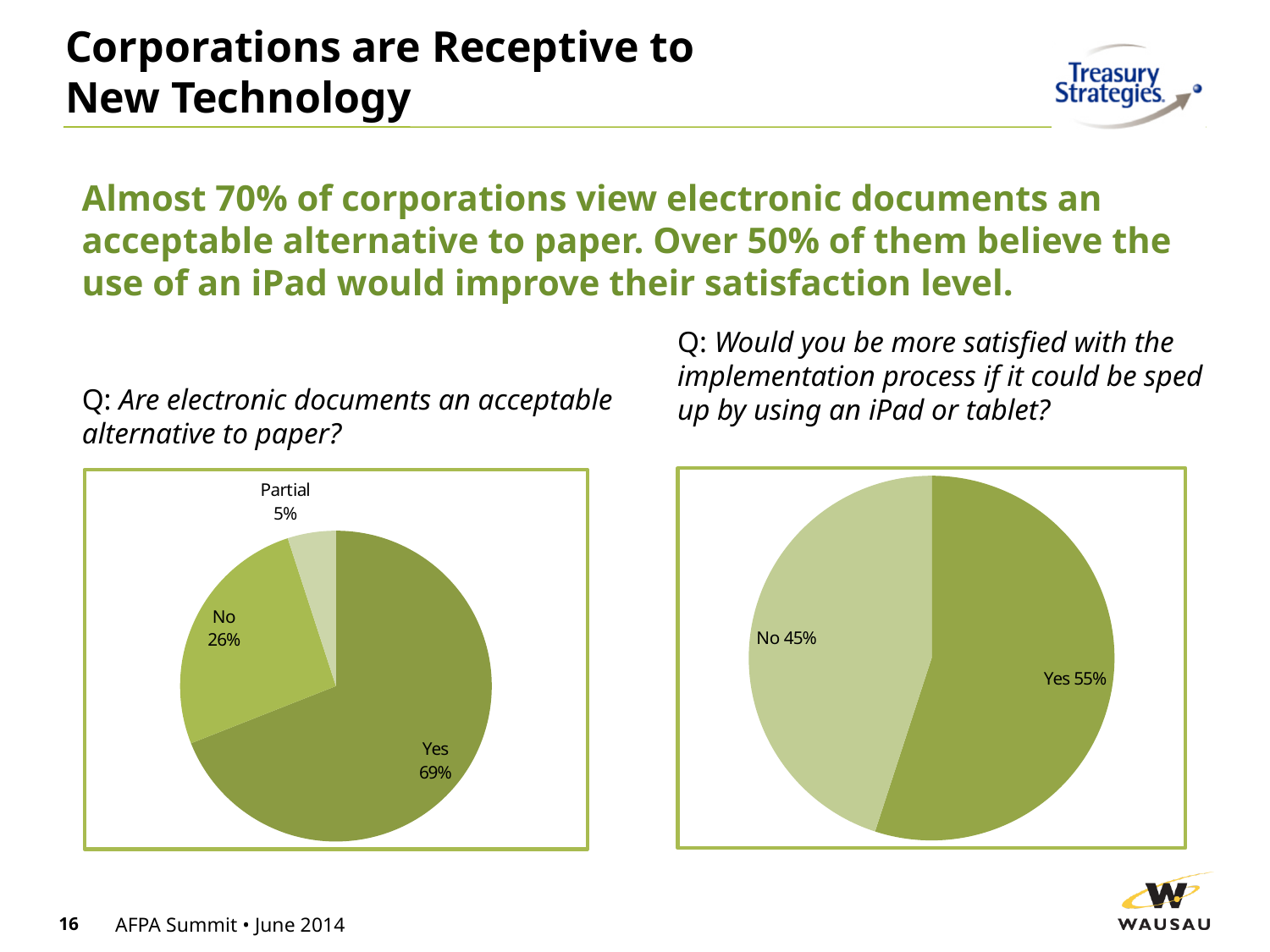
In the left pie chart (electronic documents as an acceptable alternative to paper), what share of respondents answered Partial? 5% In the left pie chart (electronic documents as an acceptable alternative to paper), what share of respondents answered No? 26% What type of chart is used for both charts on the slide? Pie chart In the left pie chart (electronic documents as an acceptable alternative to paper), what is the difference in percentage points between Yes and No? 43 percentage points In the left pie chart (electronic documents as an acceptable alternative to paper), how many slices does the pie have? 3 In the left pie chart (electronic documents as an acceptable alternative to paper), what share of respondents answered Yes? 69% In the right pie chart (satisfaction if sped up by using an iPad or tablet), what is the difference in percentage points between Yes and No? 10 percentage points In the right pie chart (satisfaction if sped up by using an iPad or tablet), which response is larger, Yes or No? Yes In the left pie chart (electronic documents as an acceptable alternative to paper), which response has the largest slice? Yes In the right pie chart (satisfaction if sped up by using an iPad or tablet), what share of respondents answered Yes? 55% In the left pie chart (electronic documents as an acceptable alternative to paper), which response has the smallest slice? Partial In the right pie chart (satisfaction if sped up by using an iPad or tablet), what share of respondents answered No? 45%